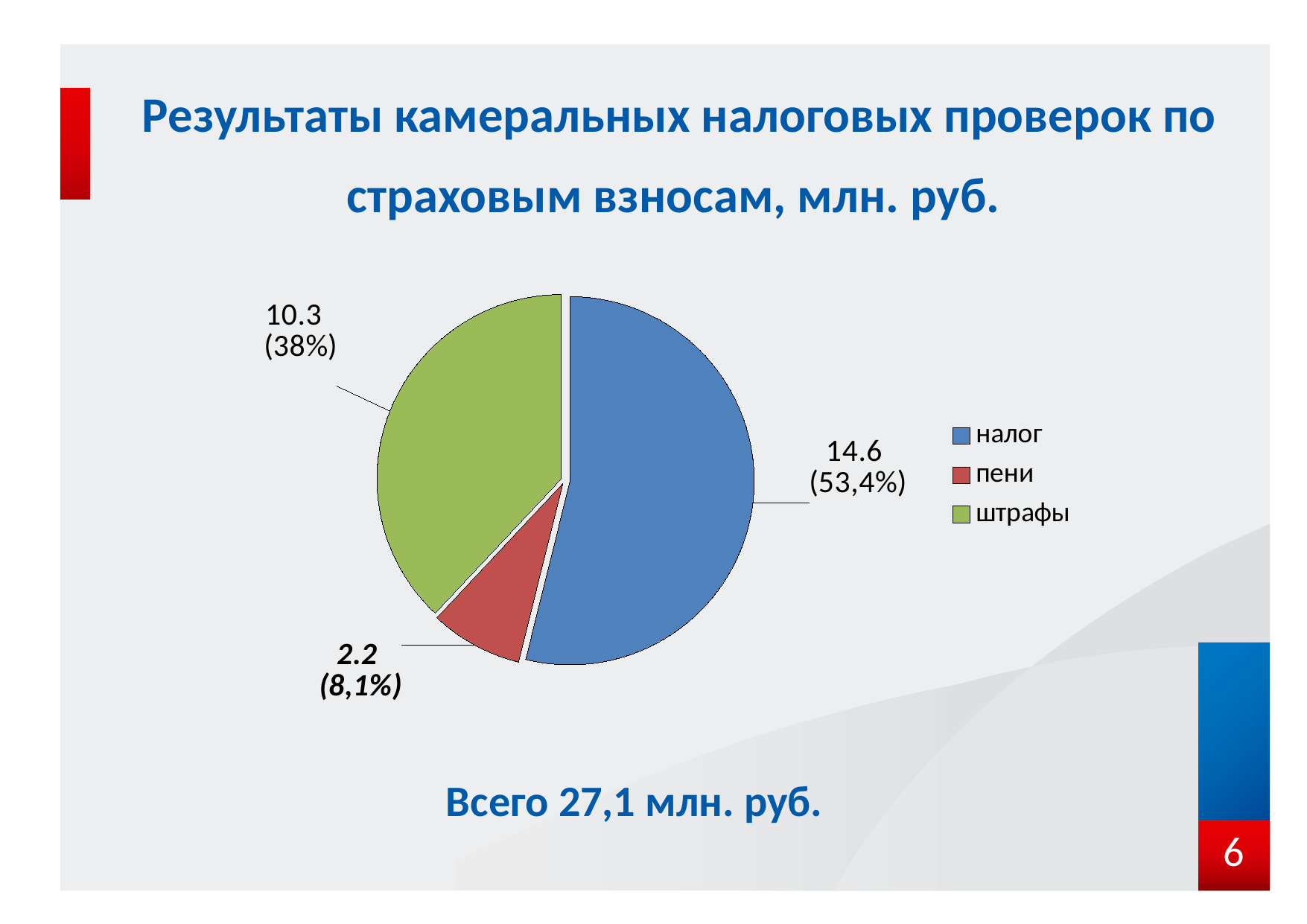
What value is shown for the пени slice? 2.2 Which category has the largest slice of the pie? налог What value is shown for the штрафы slice? 10.3 What share of the pie does the налог slice represent? 53,4% Which is larger, the value for штрафы or the value for пени? штрафы Which category has the smallest slice of the pie? пени What share of the pie does the пени slice represent? 8,1% What value is shown for the налог slice? 14.6 How many slices does the pie chart have? 3 What share of the pie does the штрафы slice represent? 38% What kind of chart is shown on the slide? pie chart What is the difference between the values for налог and штрафы? 4.3